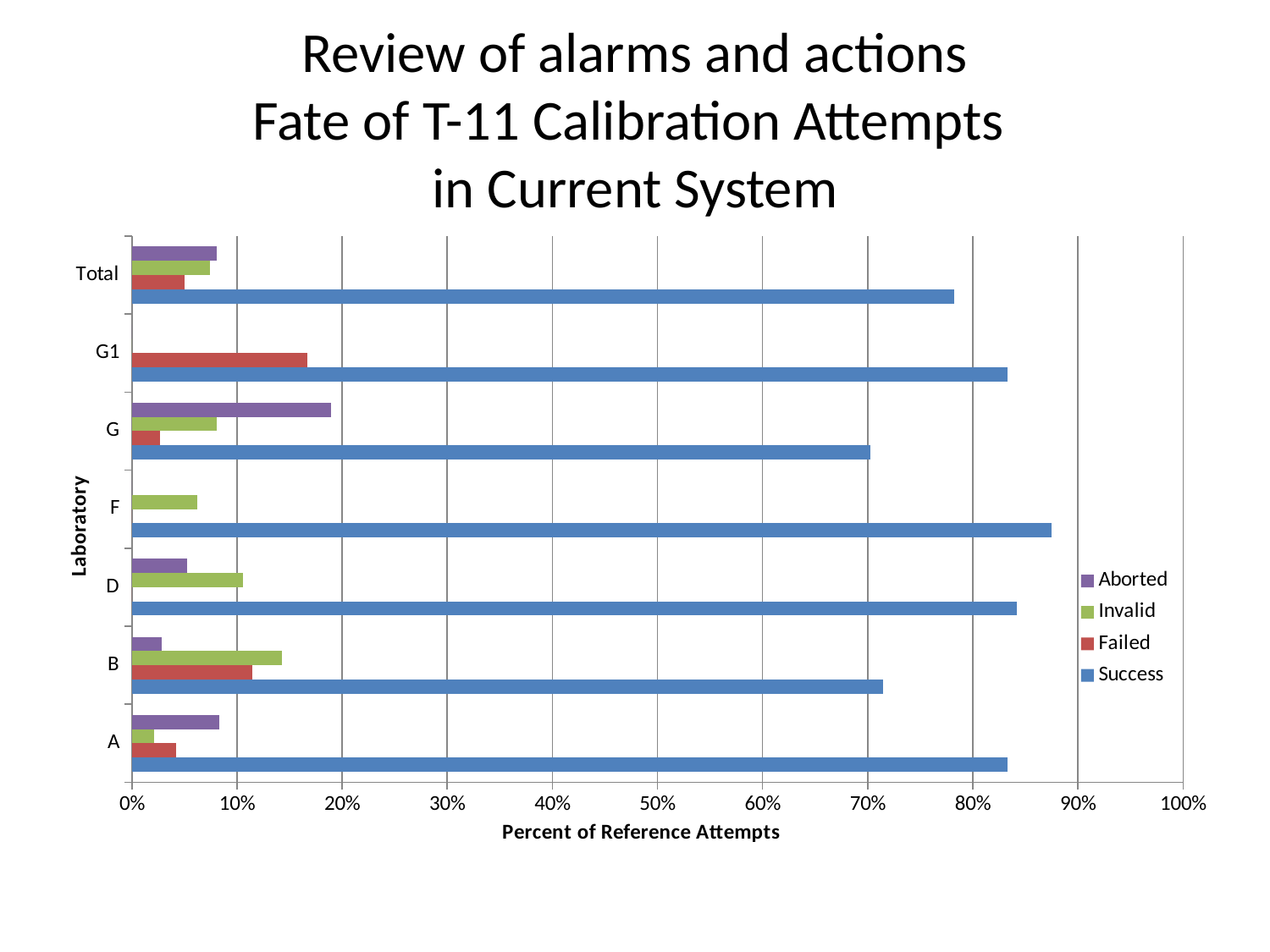
How many laboratory categories are shown on the y axis? 7 Is the Success value for G greater or less than 80%? less How many series does the legend list? 4 What is the title of the horizontal axis? Percent of Reference Attempts Which laboratory has the highest Failed value? G1 Is the Aborted value for G greater or less than 10%? greater Which is larger, the Success value for F or the Success value for G? F Which laboratory has the highest Success value? F Is the Success value for Total greater or less than 70%? greater Which laboratory has the highest Aborted value? G Which is larger, the Failed value for G1 or the Failed value for A? G1 What kind of chart is shown on the slide? bar chart